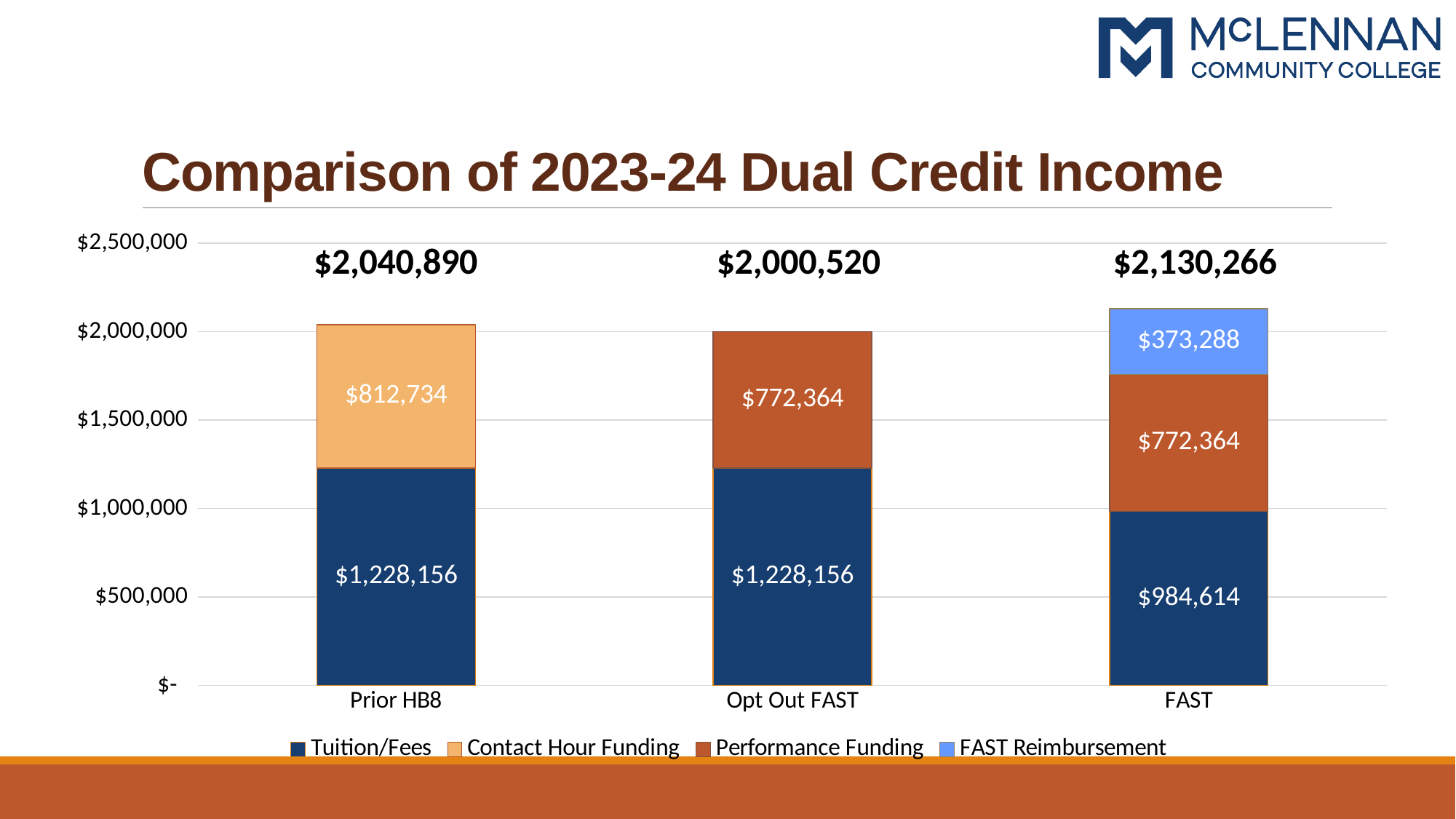
What is the Contact Hour Funding value for Prior HB8? $812,734 What is the difference between the Tuition/Fees value for Prior HB8 and the Tuition/Fees value for FAST? $243,542 How many categories are shown on the x axis? 3 Which category has the highest total income? FAST Which category has the lowest total income? Opt Out FAST What type of chart is shown on the slide? Stacked bar chart How many series does the legend list? 4 What is the title of the chart? Comparison of 2023-24 Dual Credit Income What is the FAST Reimbursement value for FAST? $373,288 What is the Tuition/Fees value for FAST? $984,614 Which is larger: the Contact Hour Funding for Prior HB8 or the Performance Funding for Opt Out FAST? Contact Hour Funding for Prior HB8 What is the total of the Opt Out FAST bar? $2,000,520